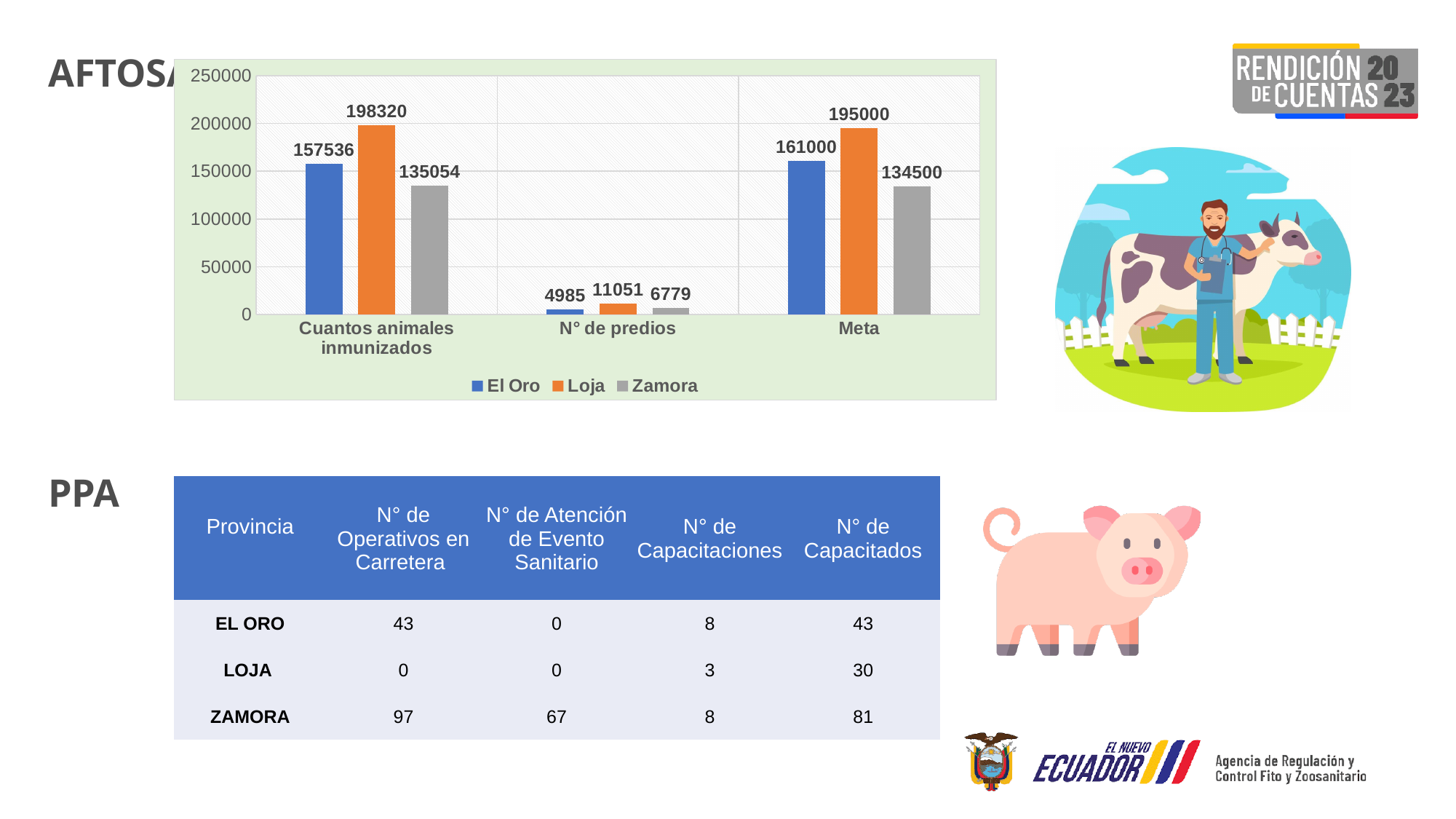
Is the value for Zamora in 'Cuantos animales inmunizados' greater or less than 150000? less How many series does the chart legend list? 3 Which is larger: El Oro's 'Meta' value or El Oro's 'Cuantos animales inmunizados' value? El Oro's 'Meta' value What is the value for El Oro in the 'N° de predios' category? 4985 How many categories are shown on the x axis of the chart? 3 What is the value for Zamora in the 'Meta' category? 134500 Which series has the highest value in the 'Meta' category? Loja Which series has the lowest value in the 'N° de predios' category? El Oro What kind of chart is shown on the slide? bar chart What is the difference between Loja and El Oro in the 'Meta' category? 34000 What is the value for Loja in the 'Cuantos animales inmunizados' category? 198320 What is the difference between Loja and El Oro in the 'Cuantos animales inmunizados' category? 40784